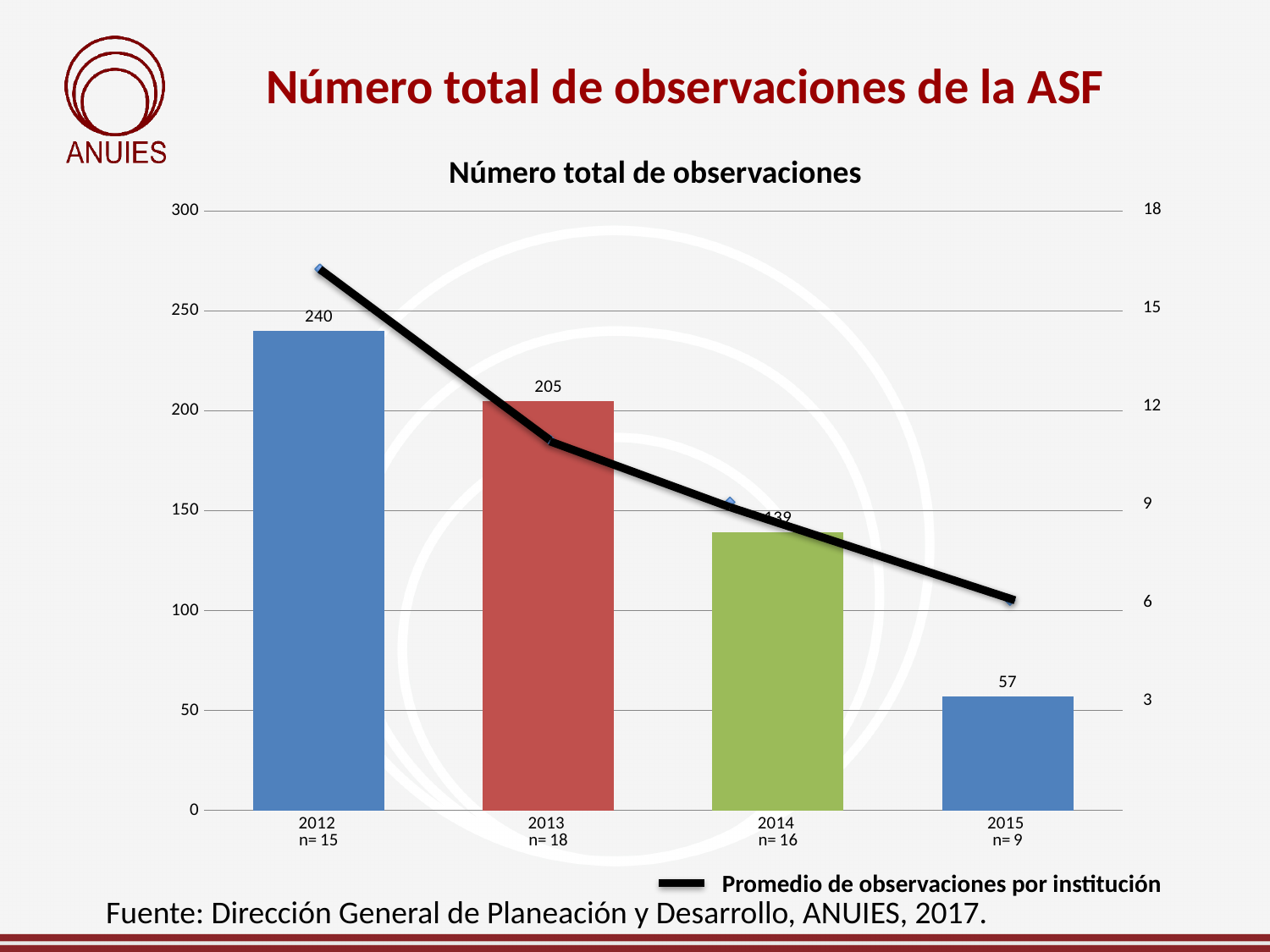
What is the total number of observations for 2012? 240 What is the difference between the total observations in 2013 and 2015? 148 What series does the black line in the legend represent? Promedio de observaciones por institución Which year has more total observations, 2013 or 2015? 2013 What is the total number of observations for 2013? 205 Is the total number of observations for 2014 greater or less than 150? less What is the total number of observations for 2015? 57 Which year has the highest total number of observations? 2012 How many years are shown on the x axis? 4 Which year has the lowest total number of observations? 2015 What is the difference between the total observations in 2012 and 2013? 35 Do the total observations rise or fall from 2012 to 2015? fall